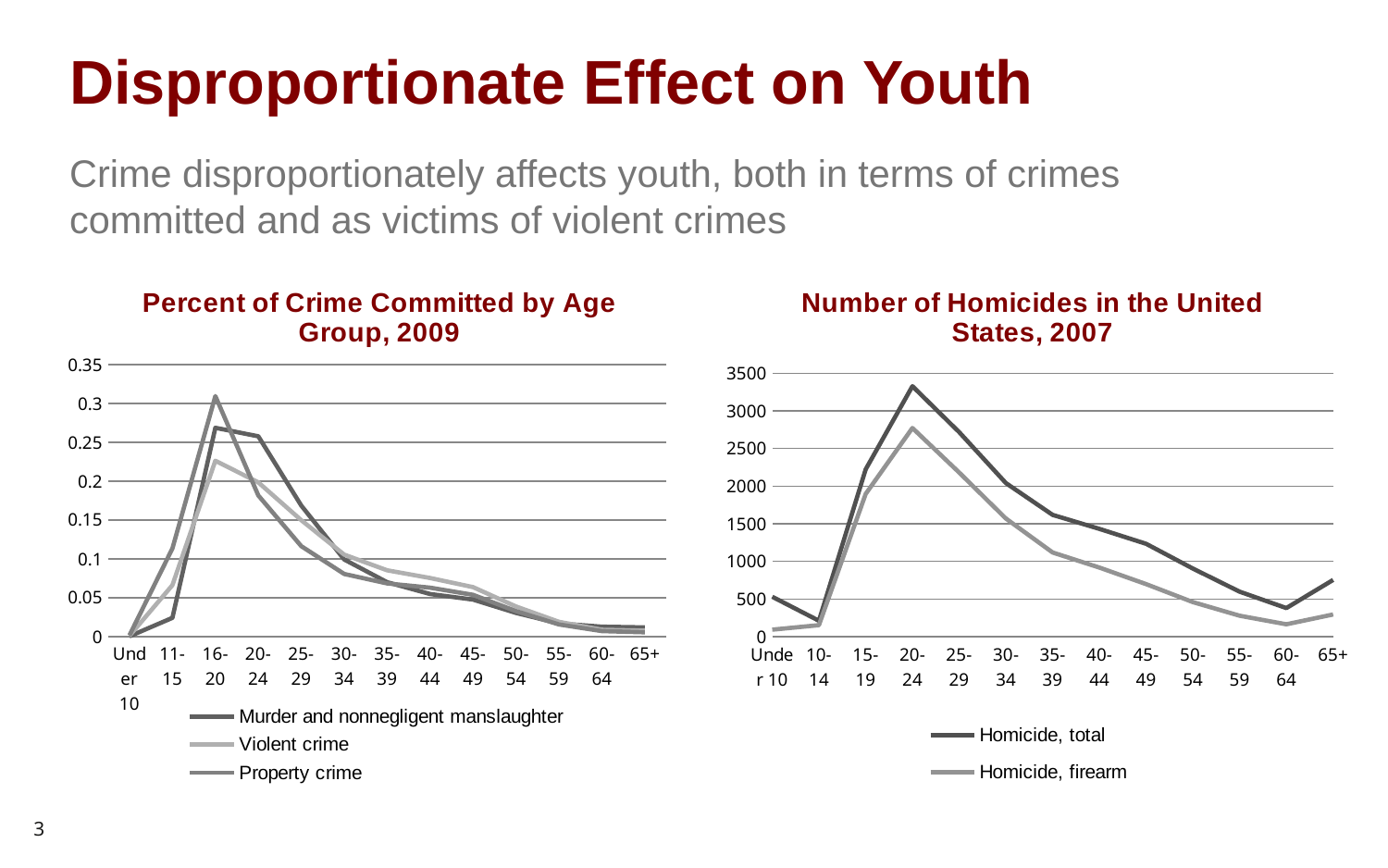
How many series does the legend of the 'Number of Homicides in the United States, 2007' chart list? 2 In the 'Percent of Crime Committed by Age Group, 2009' chart, is the value for Property crime at 16-20 greater or less than 0.3? greater How many age groups are shown on the x axis of the 'Percent of Crime Committed by Age Group, 2009' chart? 13 In the 'Number of Homicides in the United States, 2007' chart, which age group has the lowest value for Homicide, total? 10-14 In the 'Number of Homicides in the United States, 2007' chart, is the value for Homicide, firearm at 60-64 greater or less than 500? less In the 'Number of Homicides in the United States, 2007' chart, which age group has the highest value for Homicide, total? 20-24 In the 'Percent of Crime Committed by Age Group, 2009' chart, which age group has the highest value for Property crime? 16-20 In the 'Number of Homicides in the United States, 2007' chart, is the value for Homicide, total at 20-24 greater or less than 3000? greater In the 'Percent of Crime Committed by Age Group, 2009' chart, which series has the higher value at 16-20: Property crime or Violent crime? Property crime What kind of chart is the 'Percent of Crime Committed by Age Group, 2009' chart? line chart In the 'Percent of Crime Committed by Age Group, 2009' chart, do the values for Murder and nonnegligent manslaughter rise or fall from 20-24 to 65+? fall How many series does the legend of the 'Percent of Crime Committed by Age Group, 2009' chart list? 3